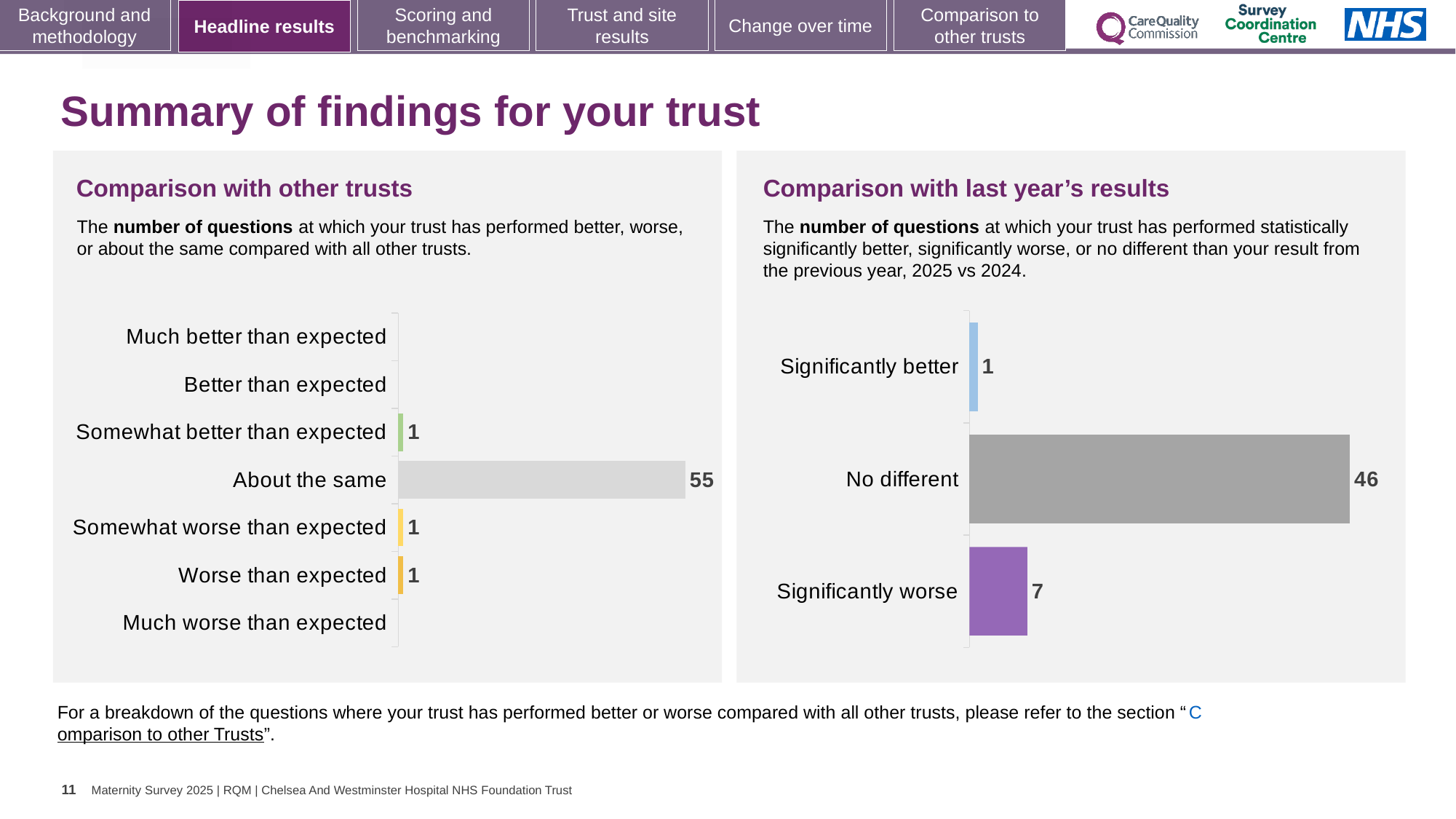
In the 'Comparison with other trusts' chart, what is the value for 'Somewhat better than expected'? 1 In the 'Comparison with last year's results' chart, what is the value for 'No different'? 46 In the 'Comparison with last year's results' chart, which is larger: 'Significantly better' or 'Significantly worse'? Significantly worse In the 'Comparison with last year's results' chart, what is the difference between 'No different' and 'Significantly worse'? 39 In the 'Comparison with last year's results' chart, which category has the lowest value? Significantly better In the 'Comparison with other trusts' chart, what is the total of the values for 'Somewhat worse than expected' and 'Worse than expected'? 2 In the 'Comparison with other trusts' chart, how many categories are listed on the axis? 7 In the 'Comparison with other trusts' chart, which category has the highest value? About the same In the 'Comparison with other trusts' chart, what is the difference between 'About the same' and 'Worse than expected'? 54 What type of chart is the 'Comparison with last year's results' chart? Bar chart In the 'Comparison with other trusts' chart, what is the value for 'About the same'? 55 In the 'Comparison with last year's results' chart, what is the value for 'Significantly worse'? 7